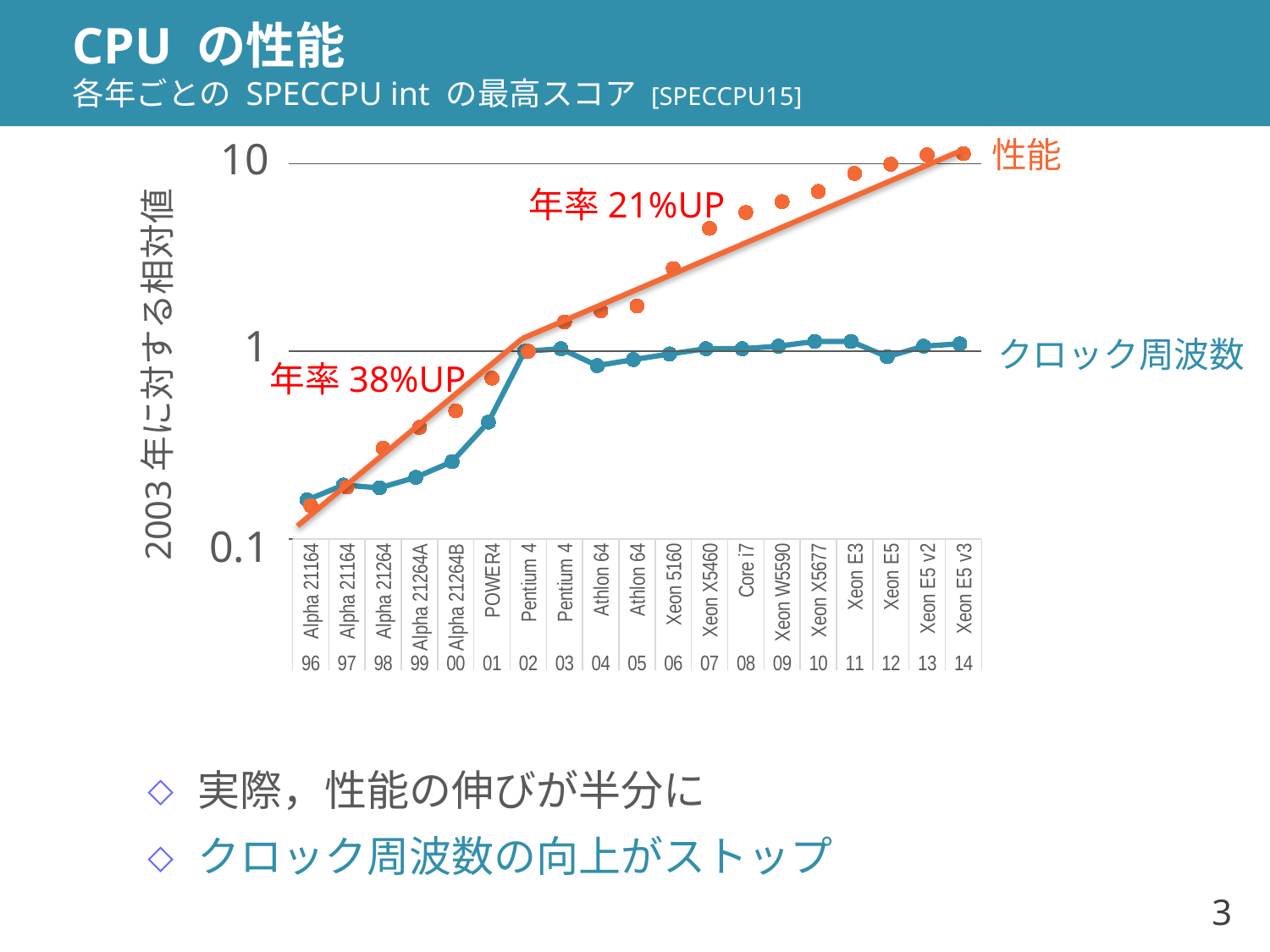
Is the クロック周波数 value for Xeon E5 v3 (14) greater or less than 10? less What are the names of the two series labelled on the chart? 性能 and クロック周波数 Which CPU has the highest 性能 value in the chart? Xeon E5 v3 How many data series are plotted in the chart? 2 What is the y-axis label of the chart? 2003 年に対する相対値 For Xeon E5 v3 (14), which series has the larger value, 性能 or クロック周波数? 性能 Which CPU has the lowest 性能 value in the chart? Alpha 21164 (96) How many CPU categories are listed along the x axis of the chart? 19 Is the クロック周波数 value for Alpha 21164 (96) greater or less than 1? less Is the 性能 value for Core i7 (08) greater or less than 1? greater Does the 性能 series rise or fall from 96 to 14 along the x axis? rise What kind of chart is shown on the slide? line chart